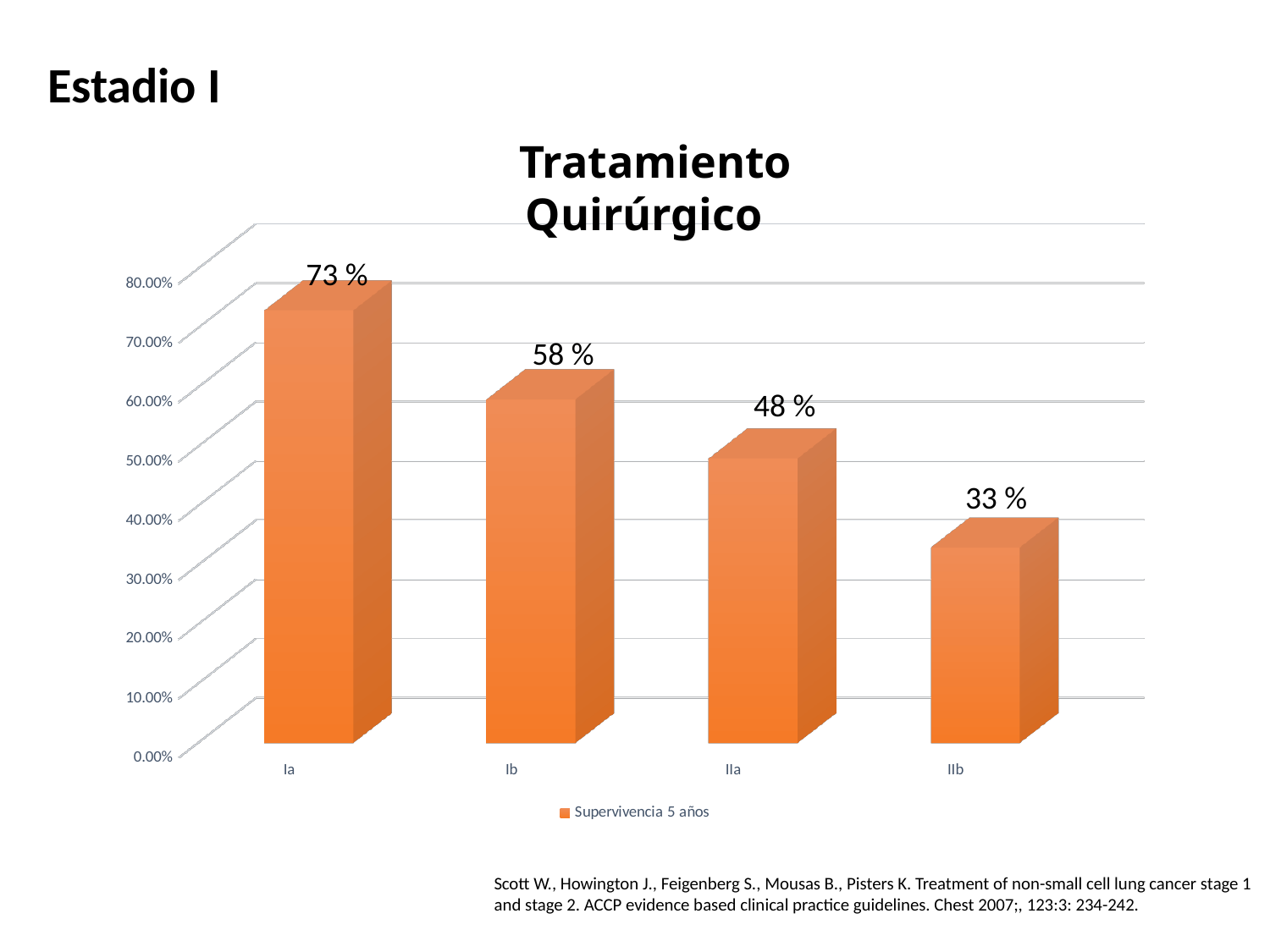
What is the difference between the values for stage Ia and stage IIb? 40 % What kind of chart is shown? bar chart What is the 5-year survival value for stage Ia? 73 % What is the difference between the values for stage Ib and stage IIa? 10 % Which is larger, the value for stage Ib or the value for stage IIa? Ib Which stage has the highest 5-year survival? Ia What is the 5-year survival value for stage IIb? 33 % What is the value shown for stage Ib? 58 % How many stages are shown on the x axis? 4 How many series does the legend list? 1 Do the values rise or fall from stage Ia to stage IIb? fall Which stage has the lowest 5-year survival? IIb